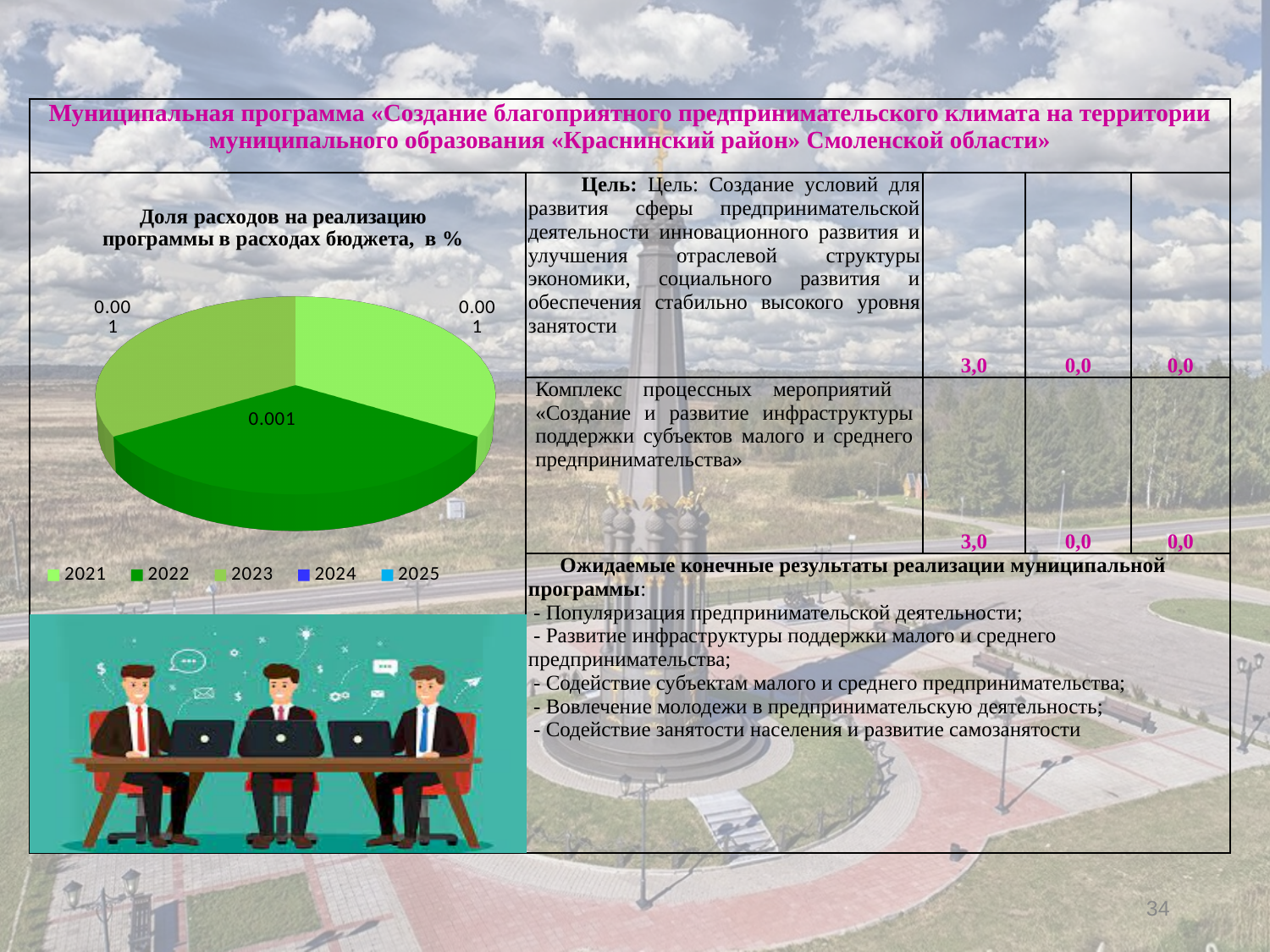
What is the title of the pie chart on the slide? Доля расходов на реализацию программы в расходах бюджета, в % How many entries does the legend of the pie chart list? 5 What kind of chart is shown on the slide? pie chart Which years are listed in the legend of the pie chart? 2021, 2022, 2023, 2024, 2025 How many slices are visibly drawn in the pie chart? 3 What value is labelled on the dark green slice of the pie chart (2022)? 0.001